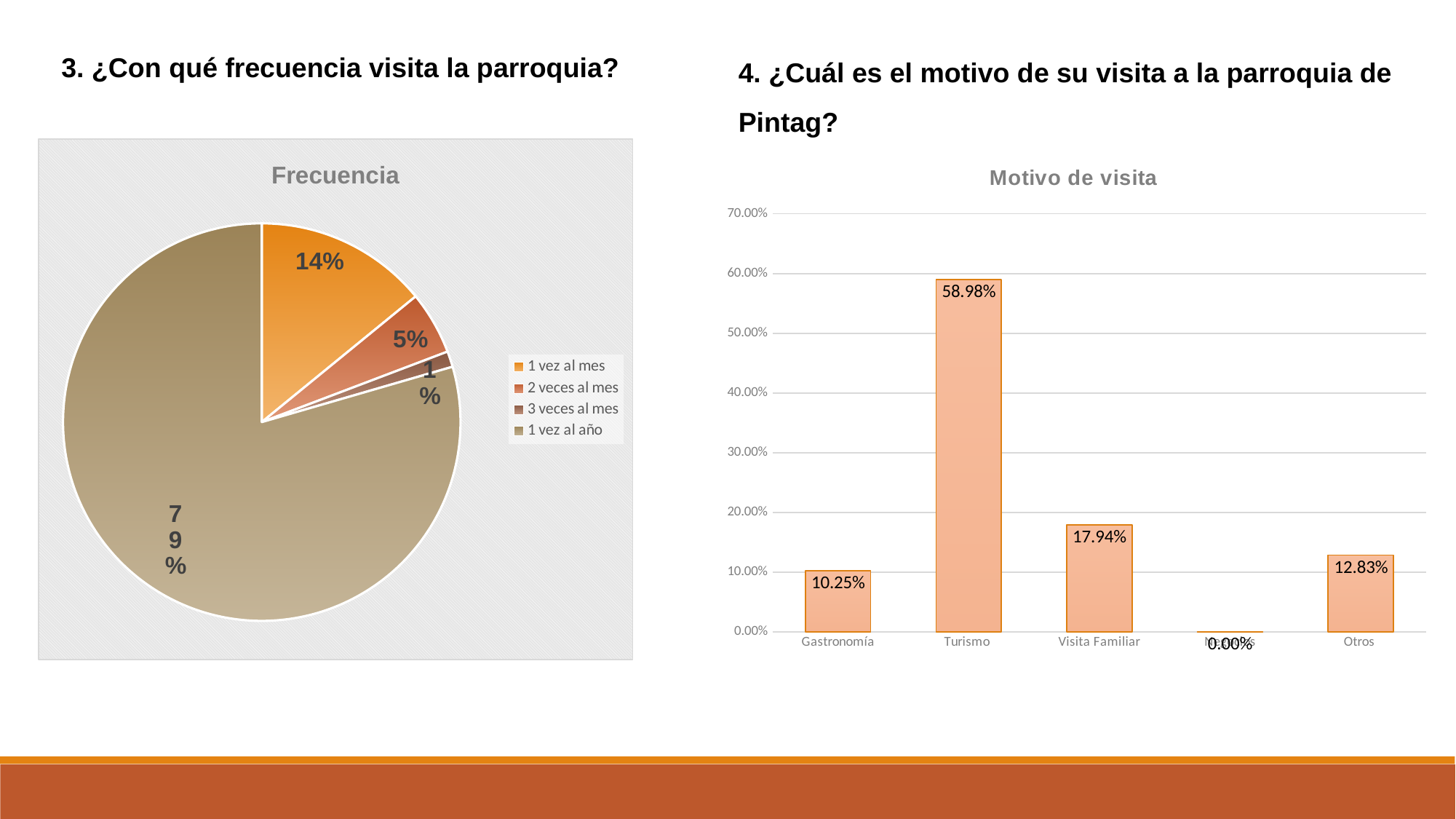
How many entries does the legend of the 'Frecuencia' pie chart list? 4 In the 'Frecuencia' pie chart, what percentage is shown for '1 vez al año'? 79% In the 'Motivo de visita' chart, which category has the highest value? Turismo In the 'Motivo de visita' chart, what is the difference between Visita Familiar and Otros? 5.11% In the 'Motivo de visita' chart, which is larger, Gastronomía or Otros? Otros In the 'Frecuencia' pie chart, which category has the smallest slice? 3 veces al mes What kind of chart is the 'Motivo de visita' chart? Bar chart In the 'Frecuencia' pie chart, which category has the largest slice? 1 vez al año What kind of chart is the 'Frecuencia' chart? Pie chart In the 'Motivo de visita' chart, what is the value for Gastronomía? 10.25% In the 'Motivo de visita' chart, what is the value for Turismo? 58.98% In the 'Frecuencia' pie chart, what percentage is shown for '1 vez al mes'? 14%